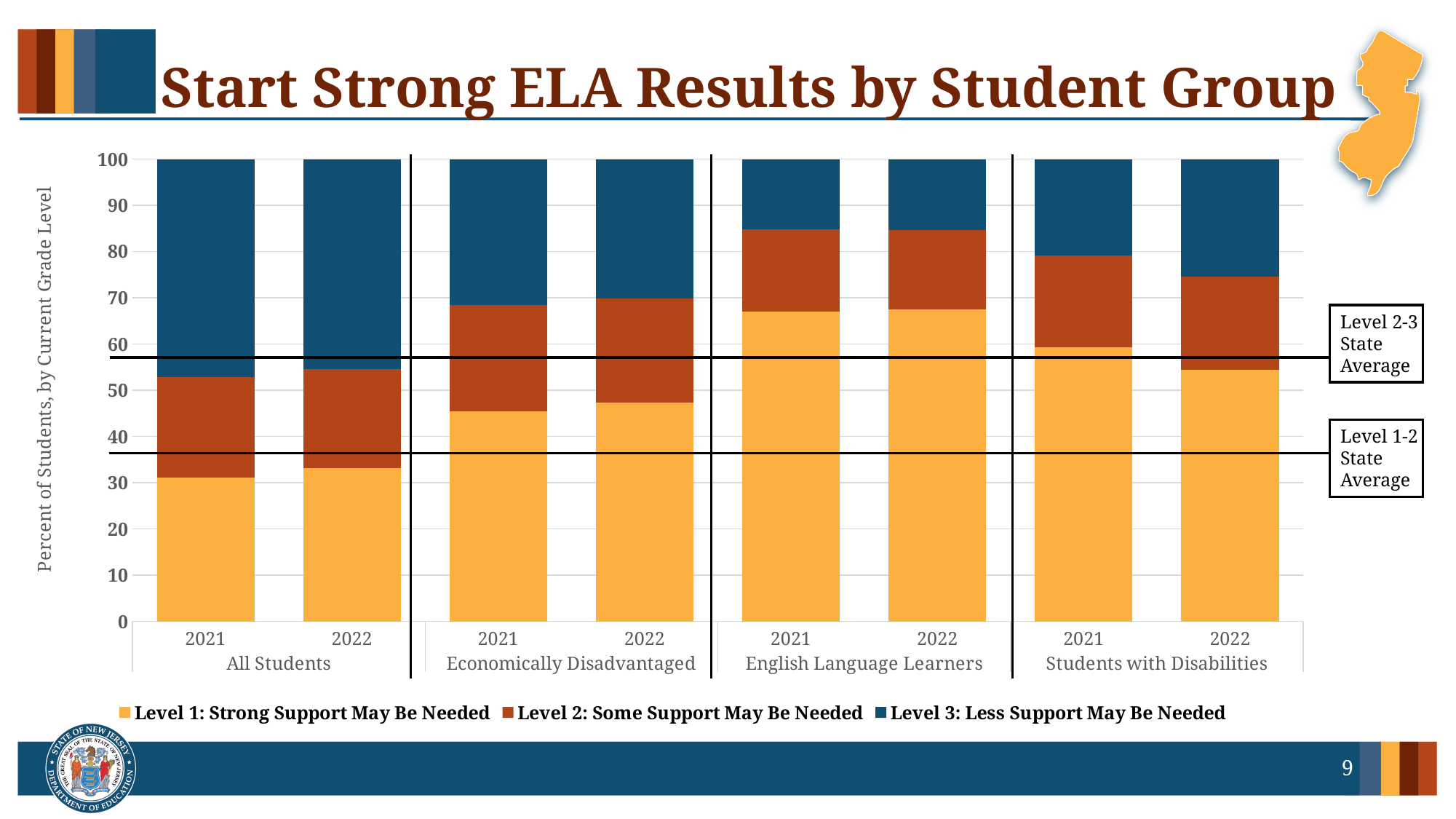
Is the Level 1 value for Economically Disadvantaged students in 2022 greater or less than 40? greater For Students with Disabilities, is the Level 1 share larger in 2021 or 2022? 2021 Which student group has the smallest Level 1 share in 2021? All Students How many student groups are shown along the x axis? 4 What is the legend label for the yellow-orange series? Level 1: Strong Support May Be Needed Is the Level 1 value for English Language Learners in 2021 greater or less than 60? greater How many series does the legend list? 3 How many bars are plotted in the chart? 8 What kind of chart is shown on the slide? Stacked bar chart Is the Level 1 value for All Students in 2021 greater or less than 40? less Does the Level 1 share for All Students rise or fall from 2021 to 2022? rise Which student group has the largest Level 1 share in 2021? English Language Learners